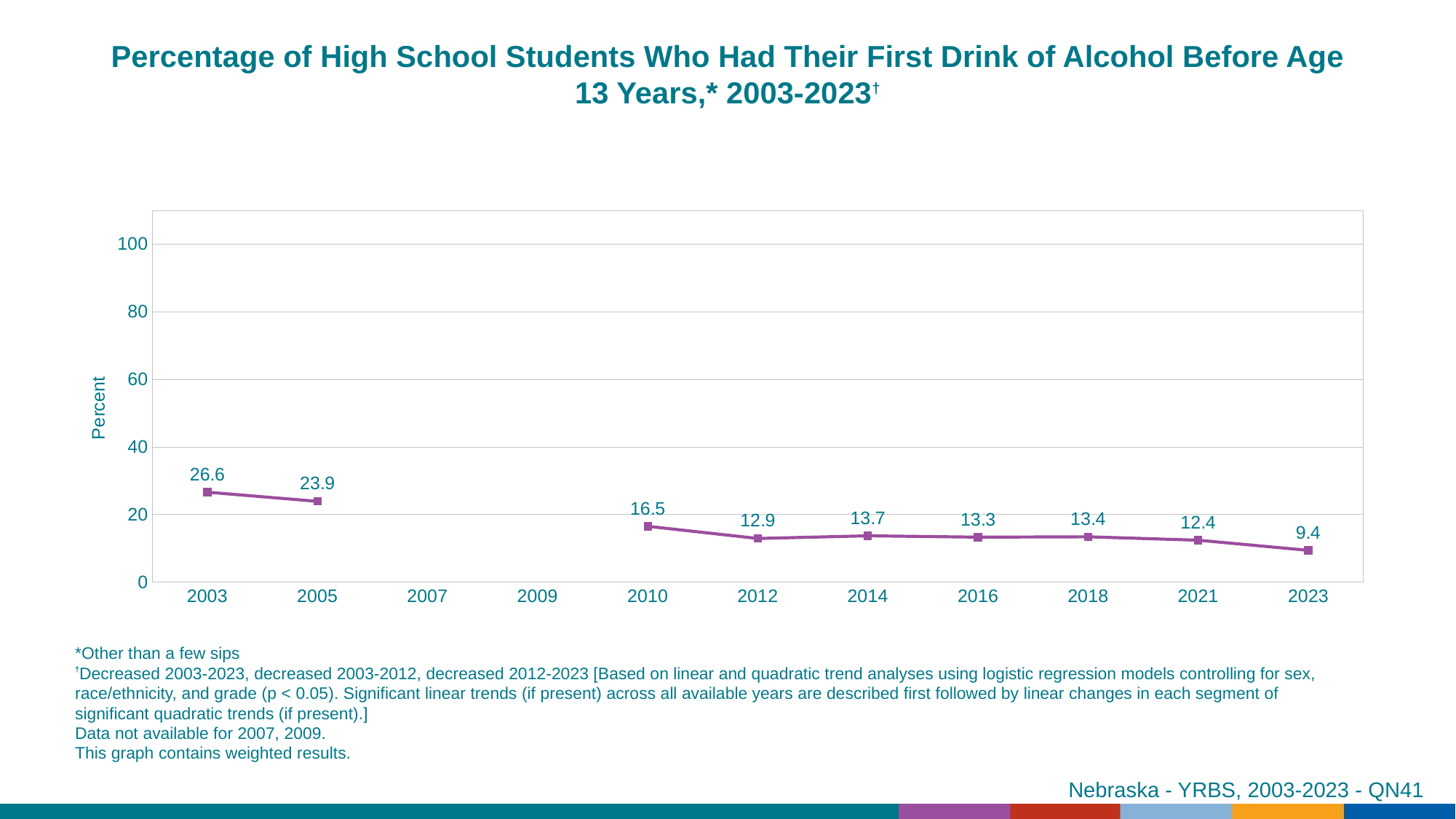
Do the plotted values generally rise or fall from 2003 to 2023? fall What kind of chart is shown on the slide? line chart Which year has the larger value, 2005 or 2012? 2005 What percentage of high school students had their first drink of alcohol before age 13 in 2003? 26.6 Which year has the highest plotted value? 2003 What is the value plotted for 2010? 16.5 Which year has the lowest plotted value? 2023 Which years are listed on the x axis but have no data plotted? 2007 and 2009 Is the value for 2018 greater or less than 20? less What is the value plotted for 2023? 9.4 How many data points are plotted on the chart? 9 What is the difference between the values for 2003 and 2023? 17.2